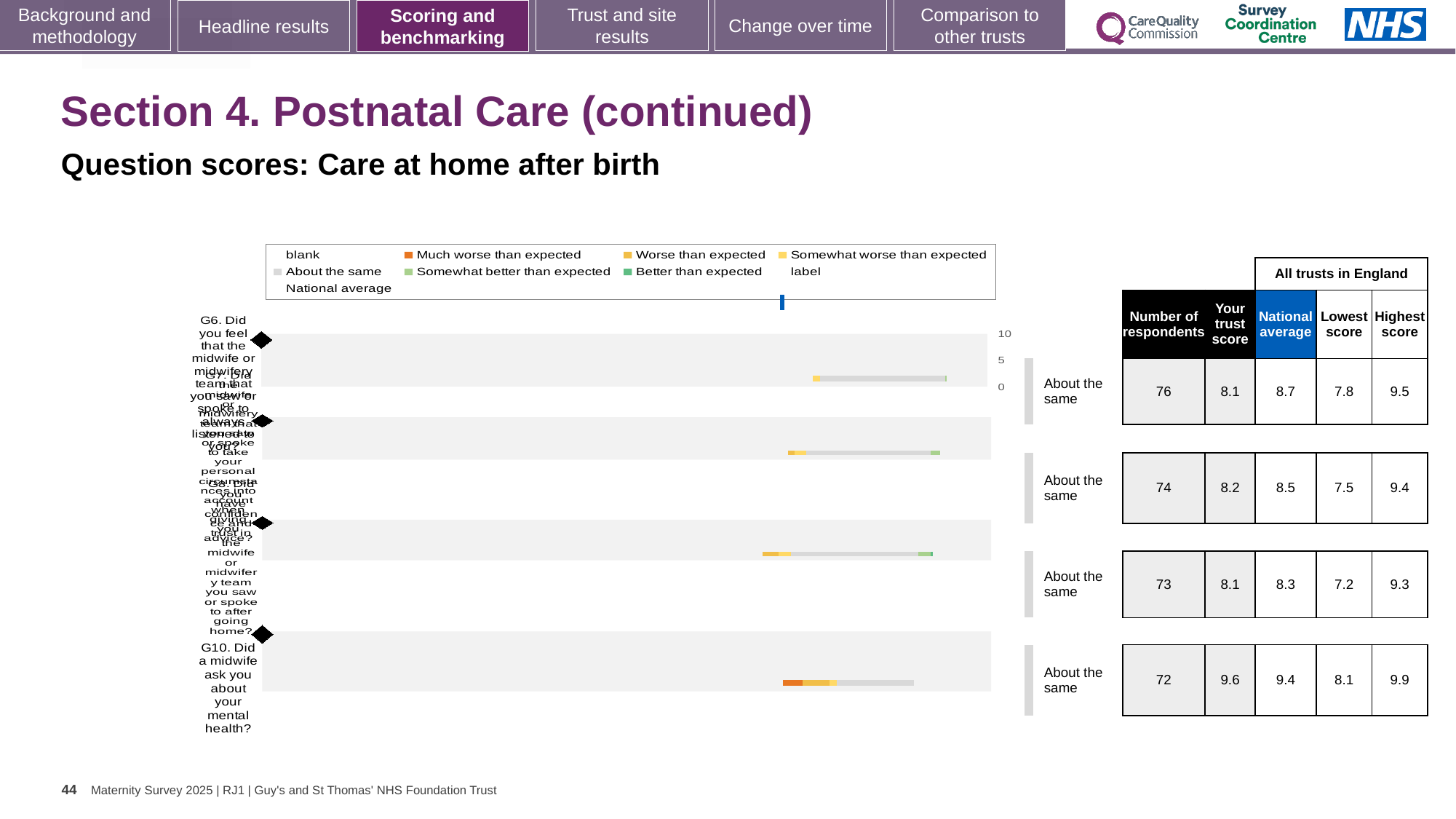
What benchmark category is shown next to the bar for G10 (Did a midwife ask you about your mental health?)? About the same In the table, which question row has the highest trust score? G10 (Did a midwife ask you about your mental health?) In the table, what is the difference between the trust score and the national average for G10? 0.2 In the table, what is the number of respondents for G10 (Did a midwife ask you about your mental health?)? 72 How many question rows (bars) are plotted in the chart? 4 What kind of chart is shown on the slide? bar chart In the table, what is the highest score in England for G10 (Did a midwife ask you about your mental health?)? 9.9 In the table, what is the number of respondents for the top question row? 76 In the table, is the trust score for G10 larger or smaller than the national average for G10? larger What colour does the legend use for 'Better than expected'? green What colour does the legend use for 'Much worse than expected'? orange In the table, what is the trust score for G10 (Did a midwife ask you about your mental health?)? 9.6